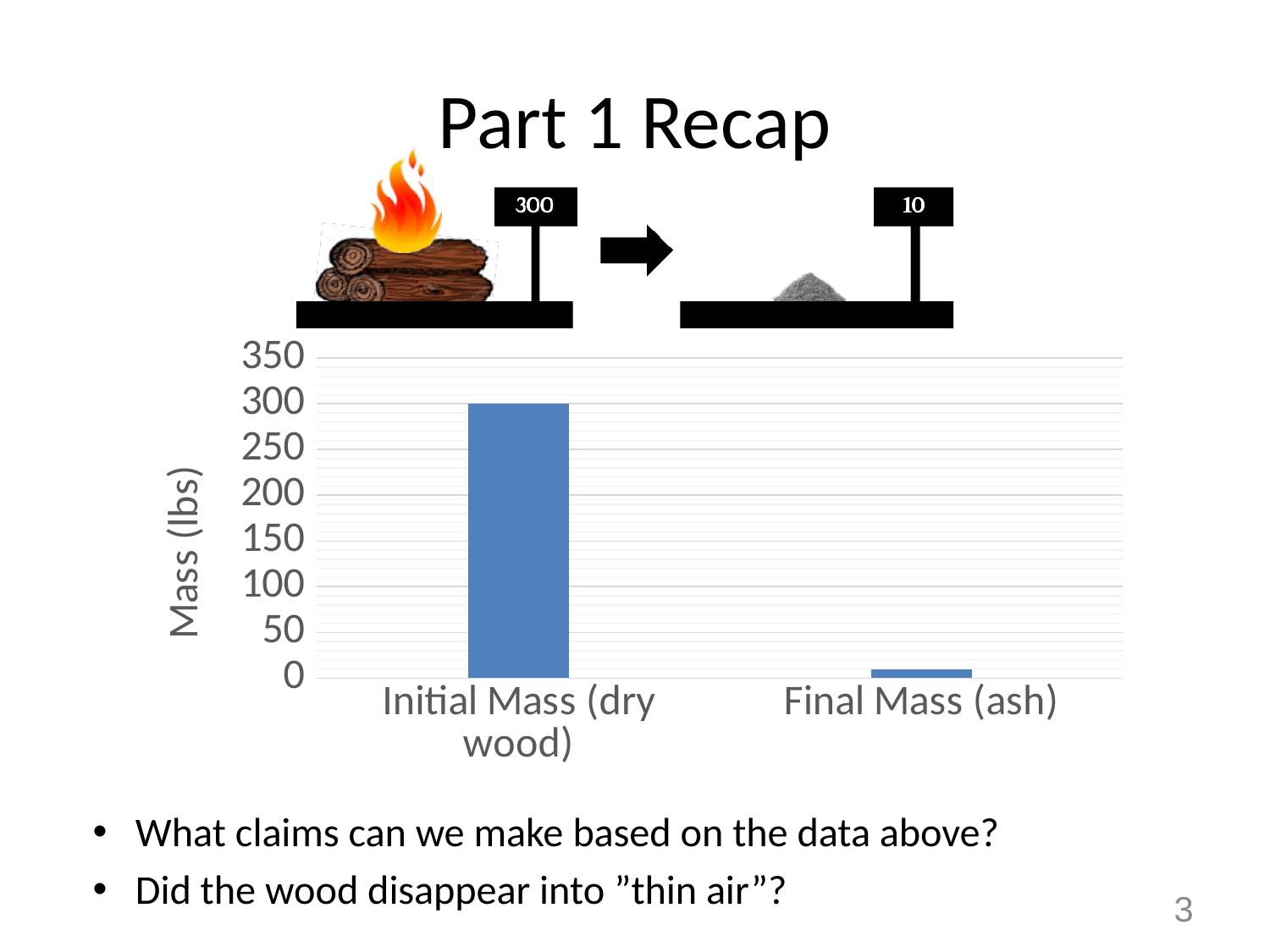
What kind of chart is shown on the slide? Bar chart Is the value for Final Mass (ash) greater or less than 50? less Is the value for Initial Mass (dry wood) greater or less than 250? greater Which category has the highest value? Initial Mass (dry wood) Do the values rise or fall from Initial Mass (dry wood) to Final Mass (ash)? Fall What is the highest value shown on the y axis? 350 Which is larger, Initial Mass (dry wood) or Final Mass (ash)? Initial Mass (dry wood) What is the label of the y axis? Mass (lbs) How many categories are shown on the x axis? 2 What is the value for Initial Mass (dry wood)? 300 Which category has the lowest value? Final Mass (ash)